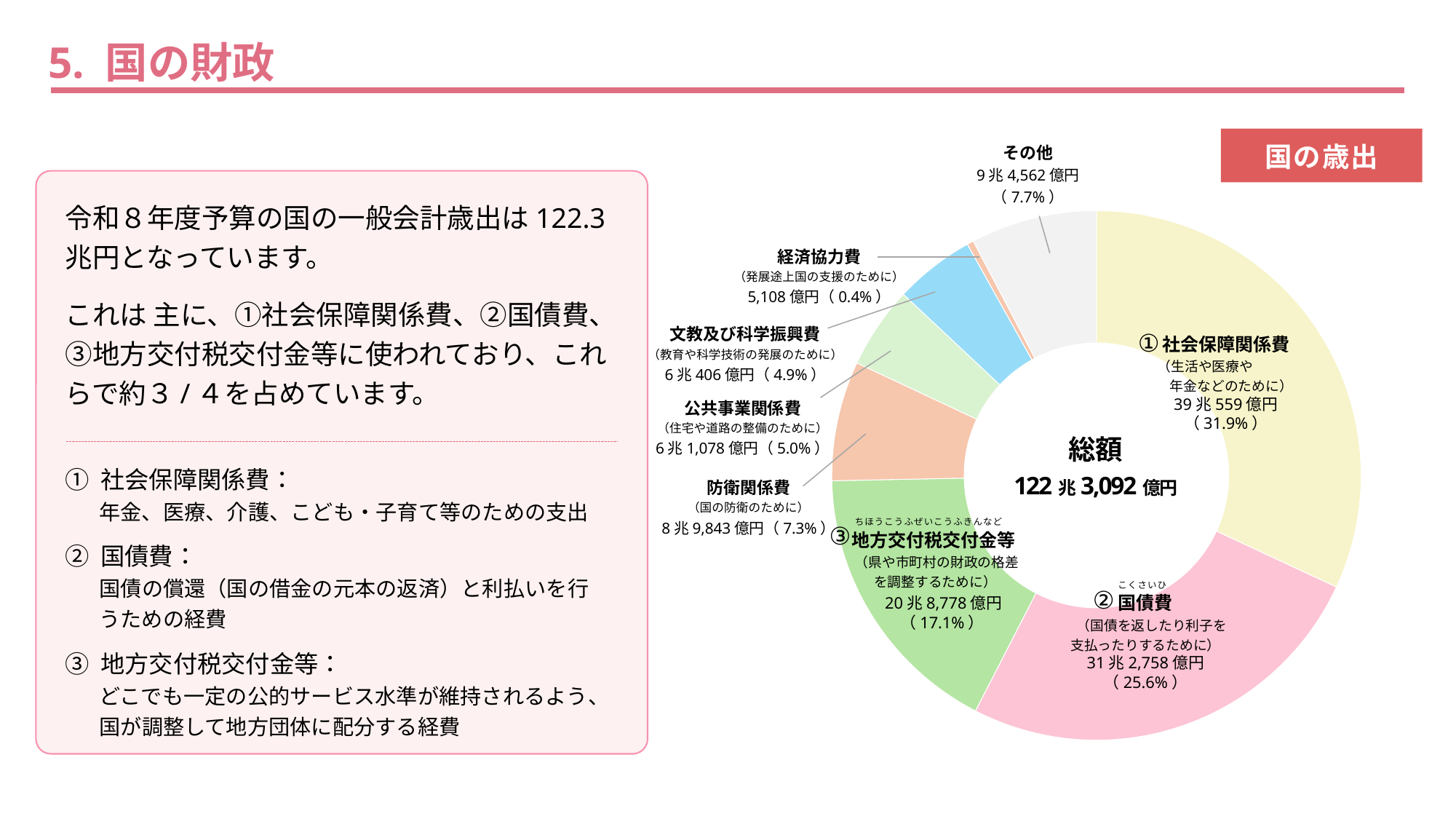
「国の歳出」のグラフで、社会保障関係費の金額はいくらですか？ 39兆559億円 「国の歳出」のグラフで、社会保障関係費と国債費の割合の差は何ポイントですか？ 6.3ポイント 「国の歳出」のグラフには、いくつの項目がありますか？ 8 「国の歳出」のグラフで、最も割合が大きい項目はどれですか？ 社会保障関係費 「国の歳出」のグラフで、国債費の割合は何％ですか？ 25.6% 「国の歳出」のグラフで、防衛関係費の割合は何％ですか？ 7.3% 「国の歳出」のグラフで、最も割合が小さい項目はどれですか？ 経済協力費 「国の歳出」のグラフの中央に示されている総額はいくらですか？ 122兆3,092億円 「国の歳出」のグラフはどの種類のグラフですか？ 円グラフ（ドーナツグラフ） 「国の歳出」のグラフで、経済協力費の金額はいくらですか？ 5,108億円 「国の歳出」のグラフで、地方交付税交付金等の金額はいくらですか？ 20兆8,778億円 「国の歳出」のグラフで、公共事業関係費と防衛関係費では、どちらの割合が大きいですか？ 防衛関係費